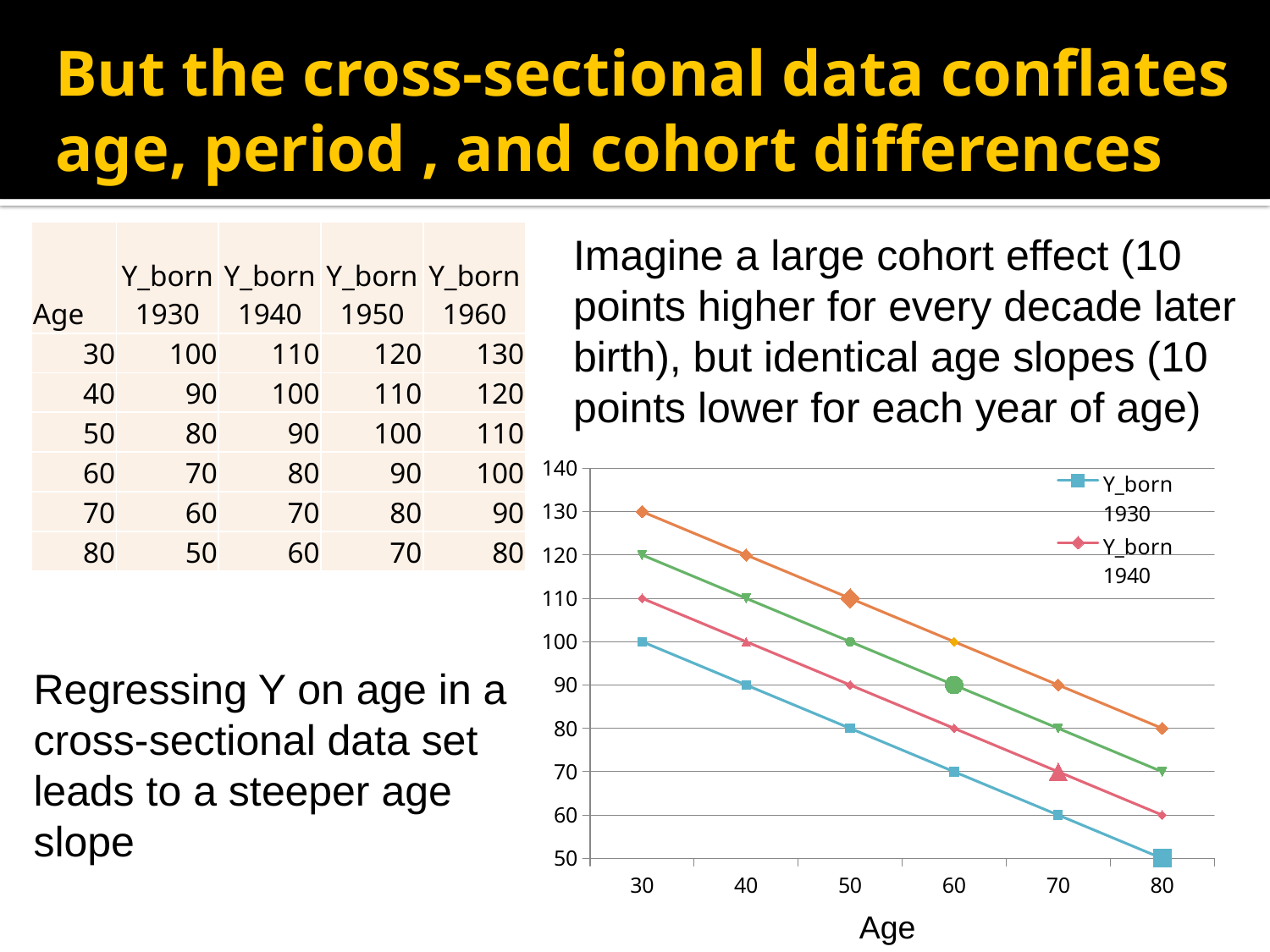
At which age does the Y_born 1940 series reach its lowest value? 80 What is the title of the x axis of the chart? Age At which age does the Y_born 1930 series reach its highest value? 30 How many age points are shown on the x axis of the chart? 6 Do the plotted values rise or fall as age increases along the x axis? fall What kind of chart is shown on the slide? line chart At age 60, which series has the higher value, Y_born 1930 or Y_born 1940? Y_born 1940 What is the difference between Y_born 1940 and Y_born 1930 at age 50? 10 What is the value for Y_born 1930 at age 80? 50 What is the value for Y_born 1940 at age 80? 60 What is the value for Y_born 1930 at age 30? 100 How many lines are plotted on the chart? 4